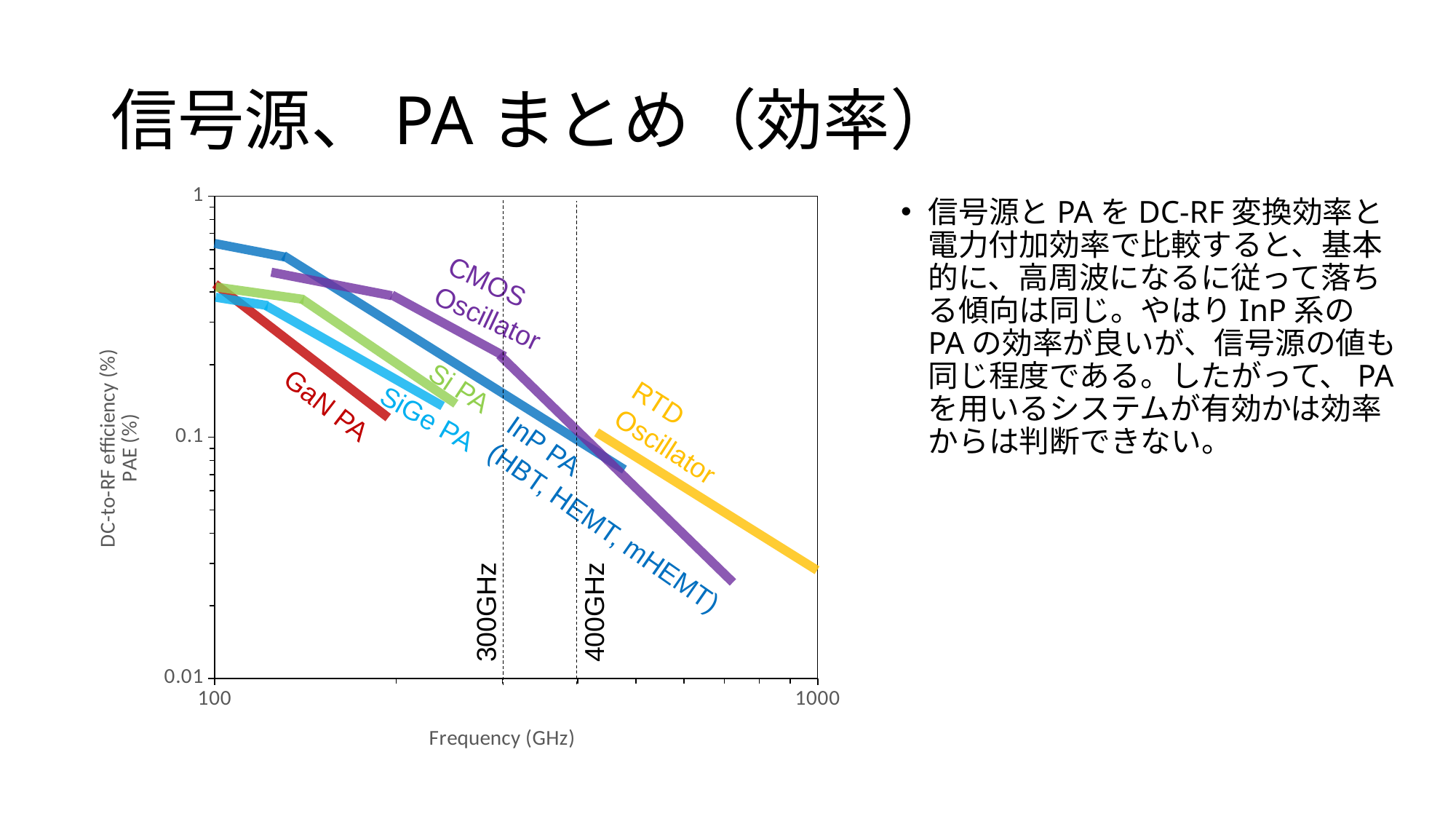
Is the value for the CMOS Oscillator at 300 GHz greater or less than 0.1? greater Which series extends to the highest frequency on the chart? RTD Oscillator How many series (labelled curves) are plotted on the chart? 6 Which series reaches the highest efficiency at 100 GHz? InP PA What kind of chart is shown on the slide? line chart Which series ends at the lowest frequency on the chart? GaN PA At what two frequencies are the vertical dashed reference lines drawn on the chart? 300GHz and 400GHz Is the value for the InP PA at 100 GHz greater or less than 0.1? greater What is the label of the x axis of the chart? Frequency (GHz) Do the efficiency values generally rise or fall as frequency increases along the x axis? fall Is the value for the RTD Oscillator at 1000 GHz greater or less than 0.1? less At 100 GHz, which is larger: the value for the InP PA or the value for the GaN PA? InP PA